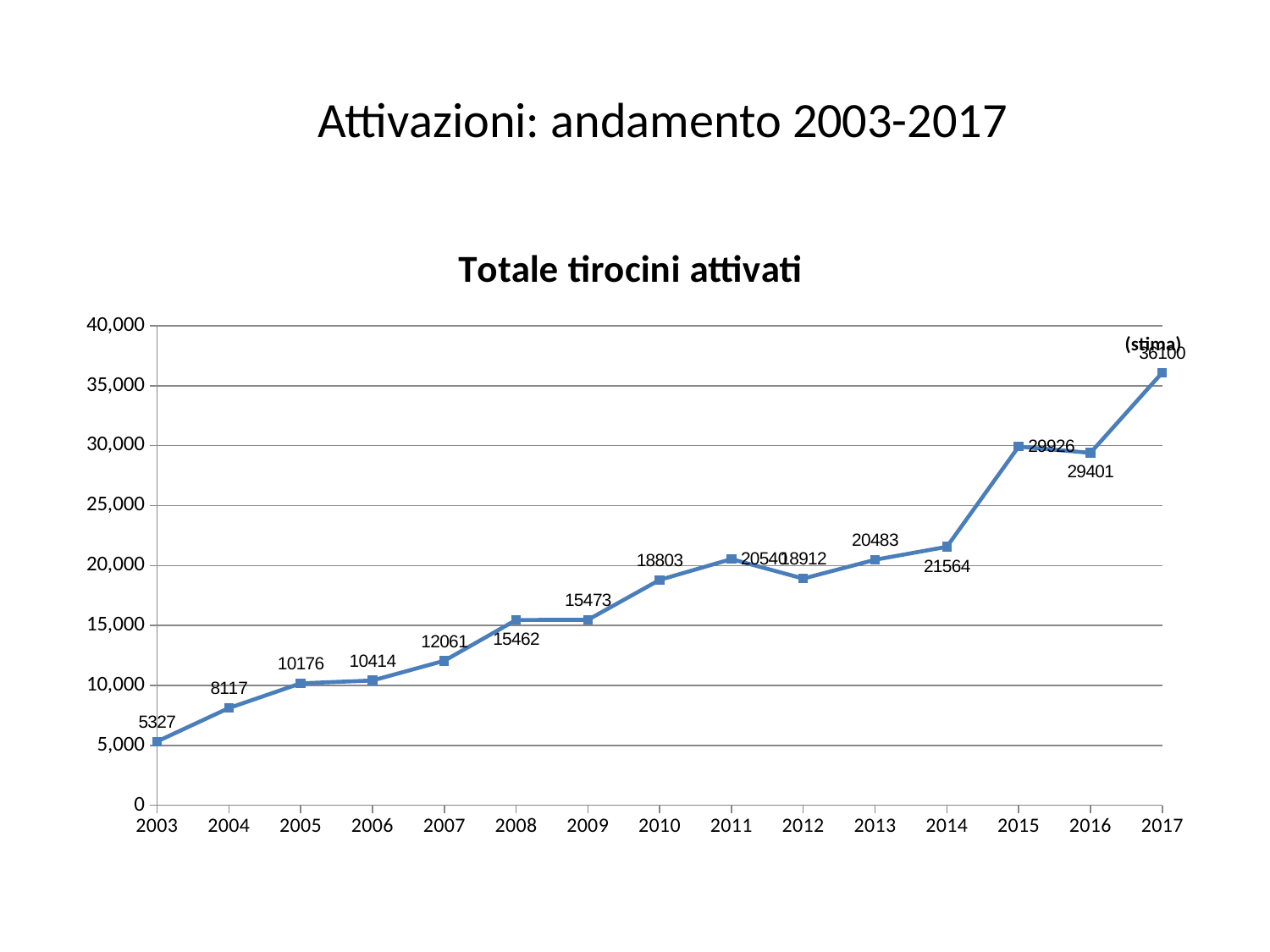
Which year has the highest value? 2017 What is the value for 2010? 18803 Do the values generally rise or fall from 2003 to 2017? rise What is the chart's title? Totale tirocini attivati What is the value for 2017? 36100 How many years are plotted on the x axis? 15 What is the difference between the values for 2015 and 2016? 525 Which year has the larger value, 2012 or 2013? 2013 What kind of chart is shown on the slide? line chart Which year has the lowest value? 2003 What is the value for 2003? 5327 What is the difference between the values for 2004 and 2003? 2790